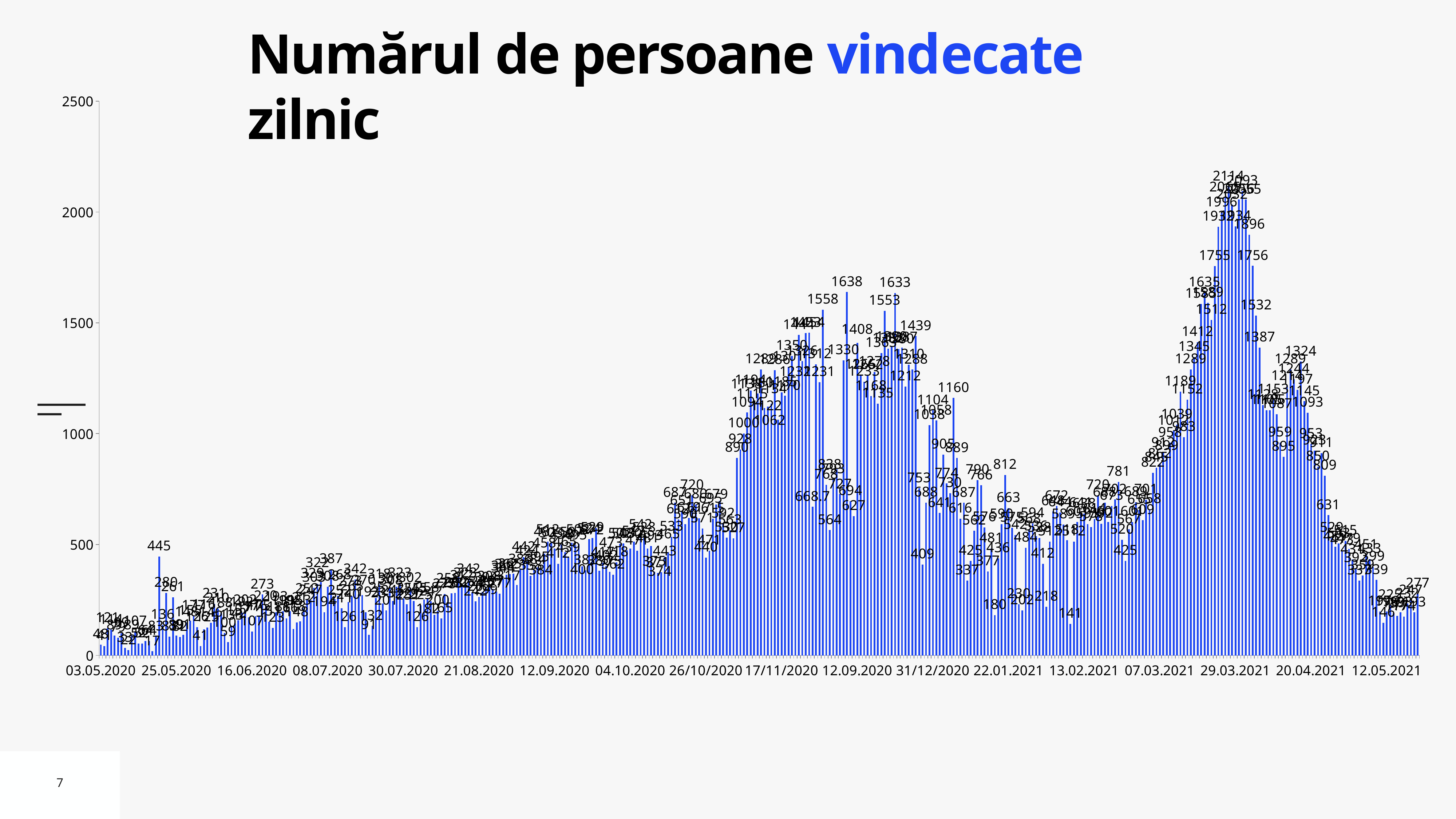
What is the maximum value shown on the vertical axis? 2500 What is the value of the lowest bar between 22.01.2021 and 13.02.2021? 141 Which peak is higher: the one in late November 2020 (1638) or the one in late March 2021 (2114)? late March 2021 What is the difference between the highest peak (2114) and the late November 2020 peak (1638)? 476 What is the highest value labeled on the chart? 2114 What kind of chart is shown on the slide? bar chart Is the value for 29.03.2021 greater or less than 1000? greater What is the title of the chart? Numărul de persoane vindecate zilnic What is the value of the tallest bar in the peak between 17/11/2020 and 31/12/2020? 1638 What is the value of the tallest bar in May 2020 (between 03.05.2020 and 25.05.2020)? 445 Is the value for the first bar (03.05.2020) greater or less than 500? less